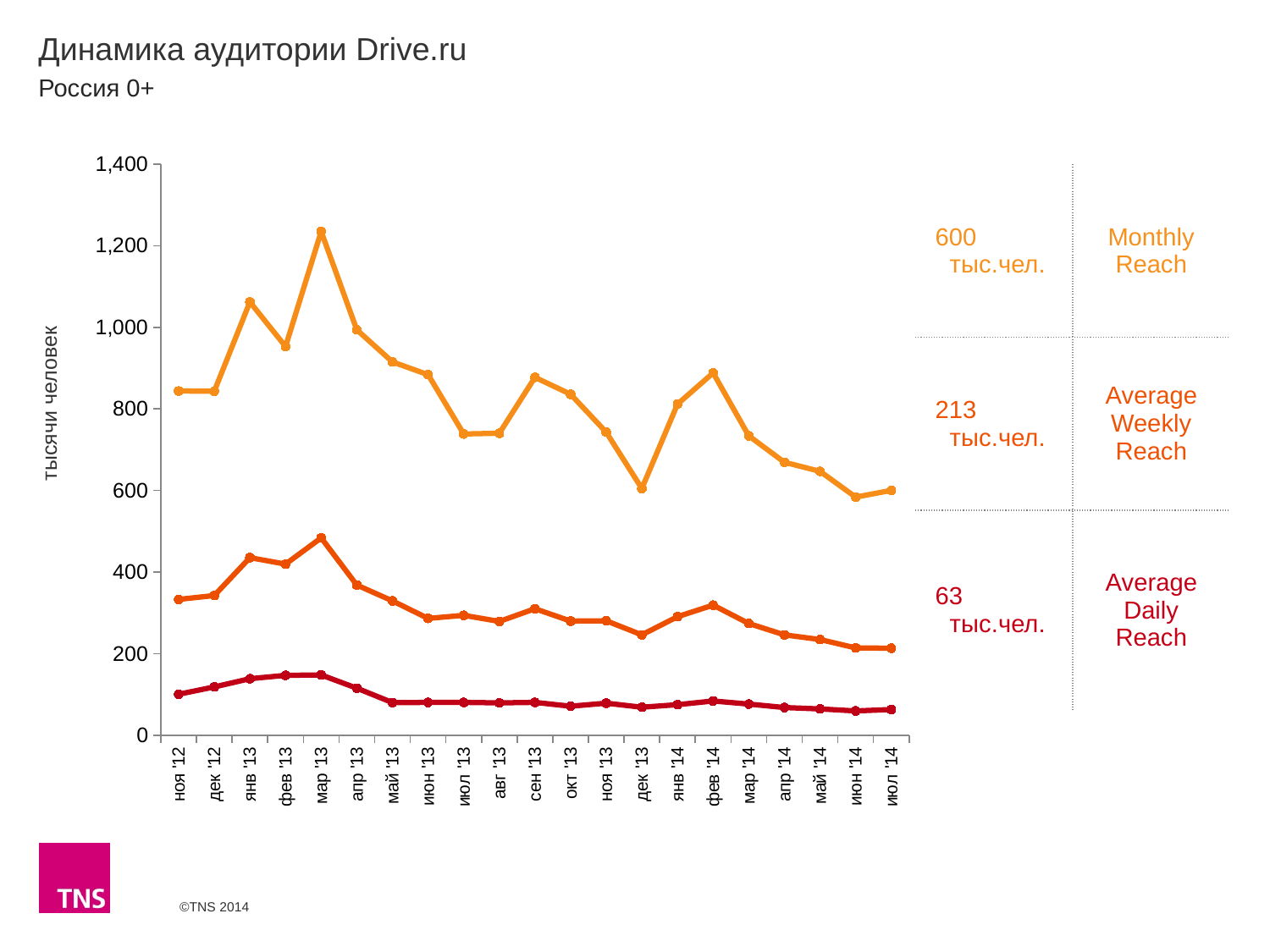
What is the Average Weekly Reach value for июл '14? 213 тыс.чел. In which month does the Monthly Reach line reach its highest point? мар '13 Which month has the higher Monthly Reach, янв '13 or фев '13? янв '13 Is the Monthly Reach value for дек '13 greater or less than 800? less What is the Monthly Reach value for июл '14? 600 тыс.чел. What is the difference between Monthly Reach and Average Weekly Reach in июл '14? 387 тыс.чел. How many series are plotted on the chart? 3 In which month does the Average Weekly Reach line reach its highest point? мар '13 What is the Average Daily Reach value for июл '14? 63 тыс.чел. How many monthly data points does each line have? 21 What kind of chart is shown on the slide? line chart Is the Monthly Reach value for мар '13 greater or less than 1,000? greater